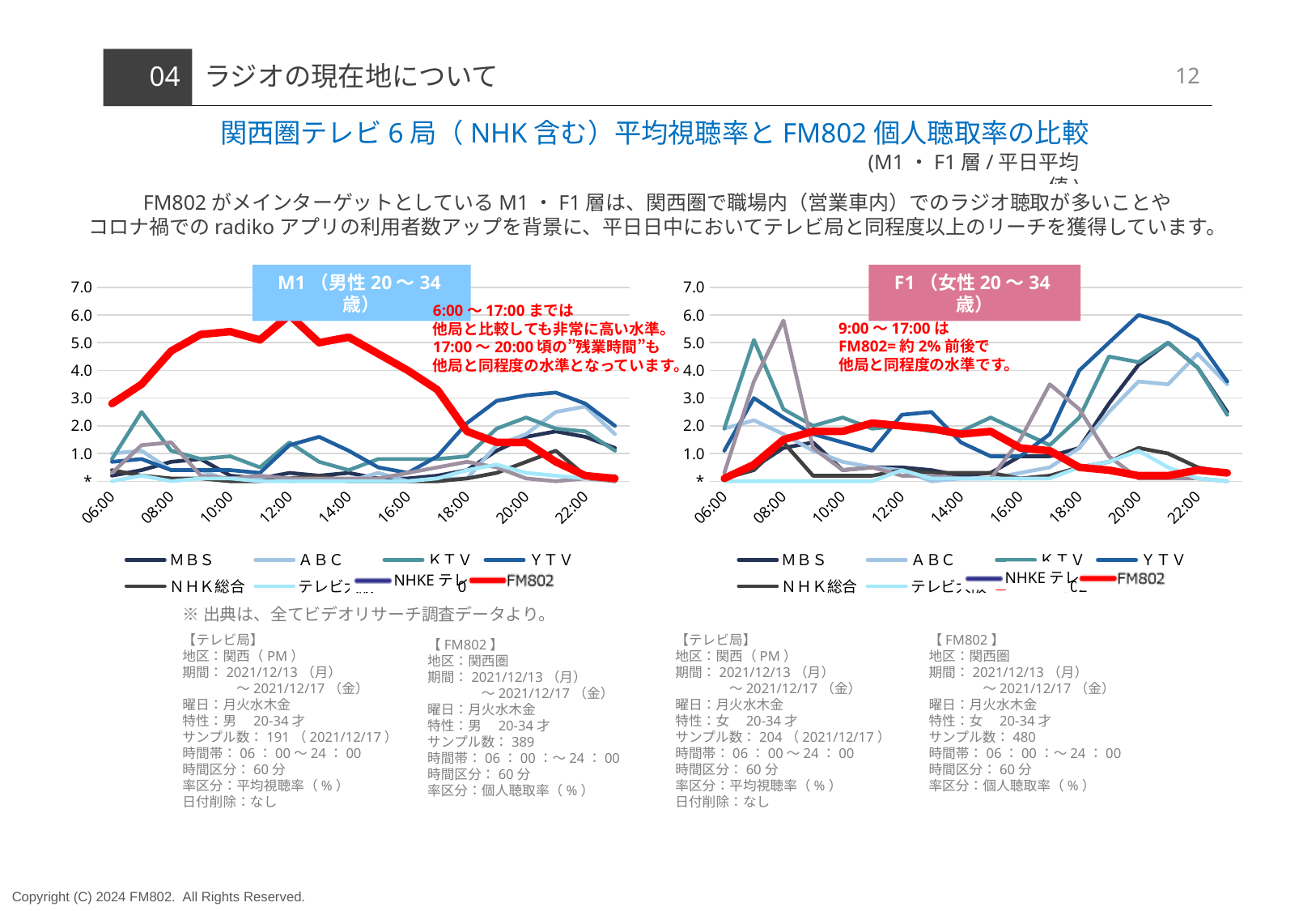
What colour is the FM802 line in both charts? red What kind of chart is the M1（男性20〜34歳）chart on the left? line chart How many series does the legend of the F1（女性20〜34歳）chart list? 8 In the F1（女性20〜34歳）chart, which series is highest at 20:00? YTV How many time labels are shown on the x axis of the M1（男性20〜34歳）chart? 9 In the M1（男性20〜34歳）chart, which series is highest at 12:00? FM802 In the M1（男性20〜34歳）chart, is the FM802 value at 22:00 greater or less than 1.0? less In the M1（男性20〜34歳）chart, does the FM802 line rise or fall from 12:00 to 22:00? fall In the F1（女性20〜34歳）chart, which is larger at 20:00, YTV or FM802? YTV In the F1（女性20〜34歳）chart, is the FM802 value at 12:00 greater or less than 3.0? less In the F1（女性20〜34歳）chart, is the YTV value at 20:00 greater or less than 5.0? greater